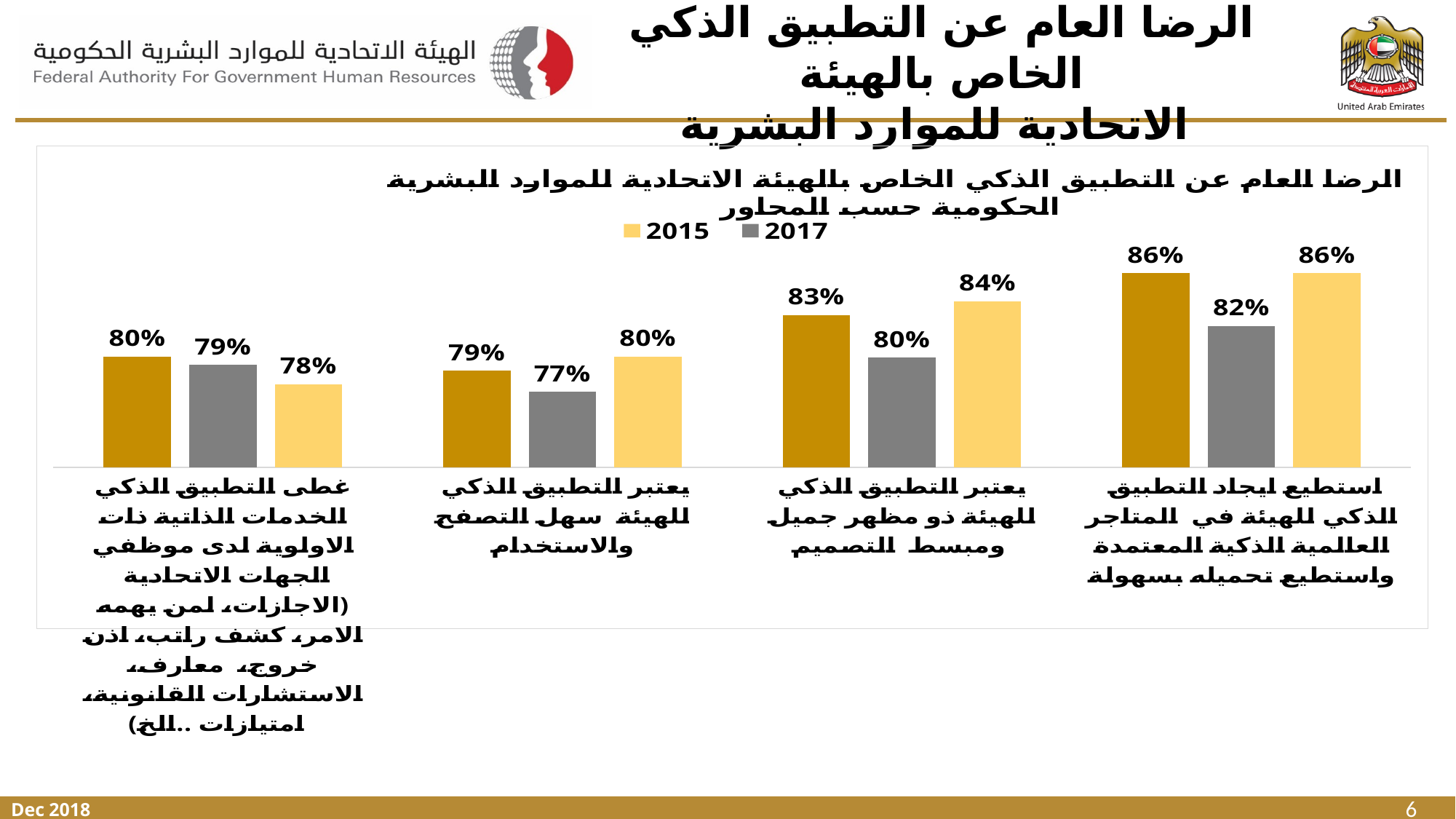
What is the 2017 value for the statement "غطى التطبيق الذكي الخدمات الذاتية ذات الاولوية لدى موظفي الجهات الاتحادية"? 79% How many series does the chart legend list? 2 What is the 2015 value for the statement "استطيع ايجاد التطبيق الذكي للهيئة في المتاجر العالمية الذكية المعتمدة واستطيع تحميله بسهولة"? 86% What is the 2017 value for the statement "يعتبر التطبيق الذكي للهيئة سهل التصفح والاستخدام"? 77% For the statement "غطى التطبيق الذكي الخدمات الذاتية ذات الاولوية لدى موظفي الجهات الاتحادية", which year has the larger value, 2015 or 2017? 2017 What is the 2015 value for the statement "يعتبر التطبيق الذكي للهيئة ذو مظهر جميل ومبسط التصميم"? 84% Which statement has the highest 2017 value? استطيع ايجاد التطبيق الذكي للهيئة في المتاجر العالمية الذكية المعتمدة واستطيع تحميله بسهولة Which statement has the lowest 2017 value? يعتبر التطبيق الذكي للهيئة سهل التصفح والاستخدام What colour does the legend use for the 2017 series? gray What is the difference between the 2015 and 2017 values for the statement "استطيع ايجاد التطبيق الذكي للهيئة في المتاجر العالمية الذكية المعتمدة واستطيع تحميله بسهولة"? 4 percentage points What kind of chart is shown on the slide? bar chart How many categories (statements) are shown along the x axis of the chart? 4